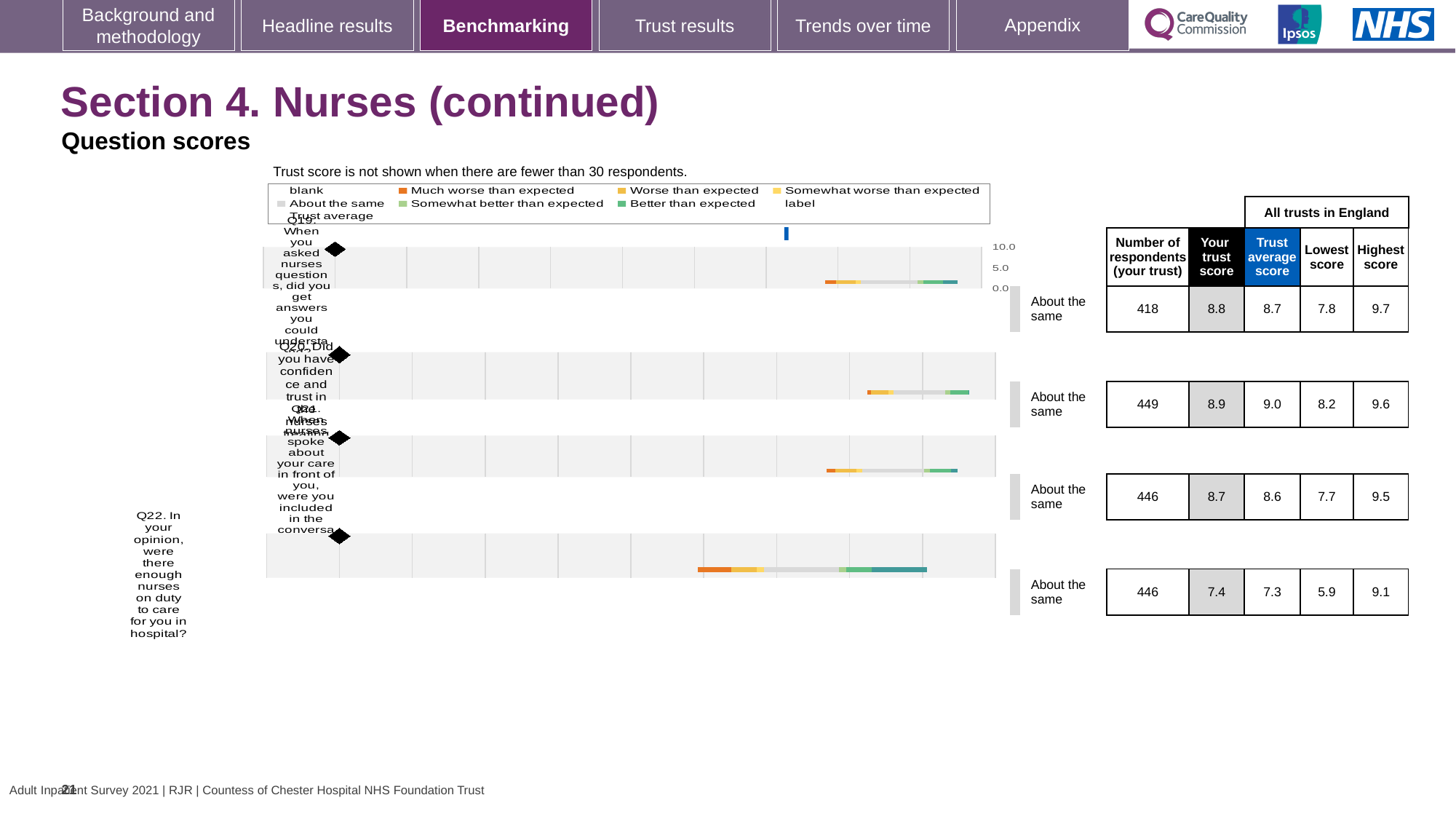
What is the 'Your trust score' for Q22 (were there enough nurses on duty to care for you in hospital)? 7.4 What is the highest score across all trusts in England for Q21 (when nurses spoke about your care in front of you, were you included in the conversation)? 9.5 Which question has the highest 'Your trust score'? Q20 What is the trust average score for Q19 (when you asked nurses questions, did you get answers you could understand)? 8.7 How many questions are shown on this slide's chart? 4 What is the lowest score across all trusts in England for Q22? 5.9 How many respondents from your trust answered Q20 (did you have confidence and trust in the nurses)? 449 Which question has the lowest 'Your trust score'? Q22 What benchmark category is shown next to each of the four questions? About the same For Q19, which is larger: your trust score or the trust average score? Your trust score For Q22, what is the difference between the highest score and the lowest score across all trusts in England? 3.2 What kind of chart is used to show the question scores? Bar chart